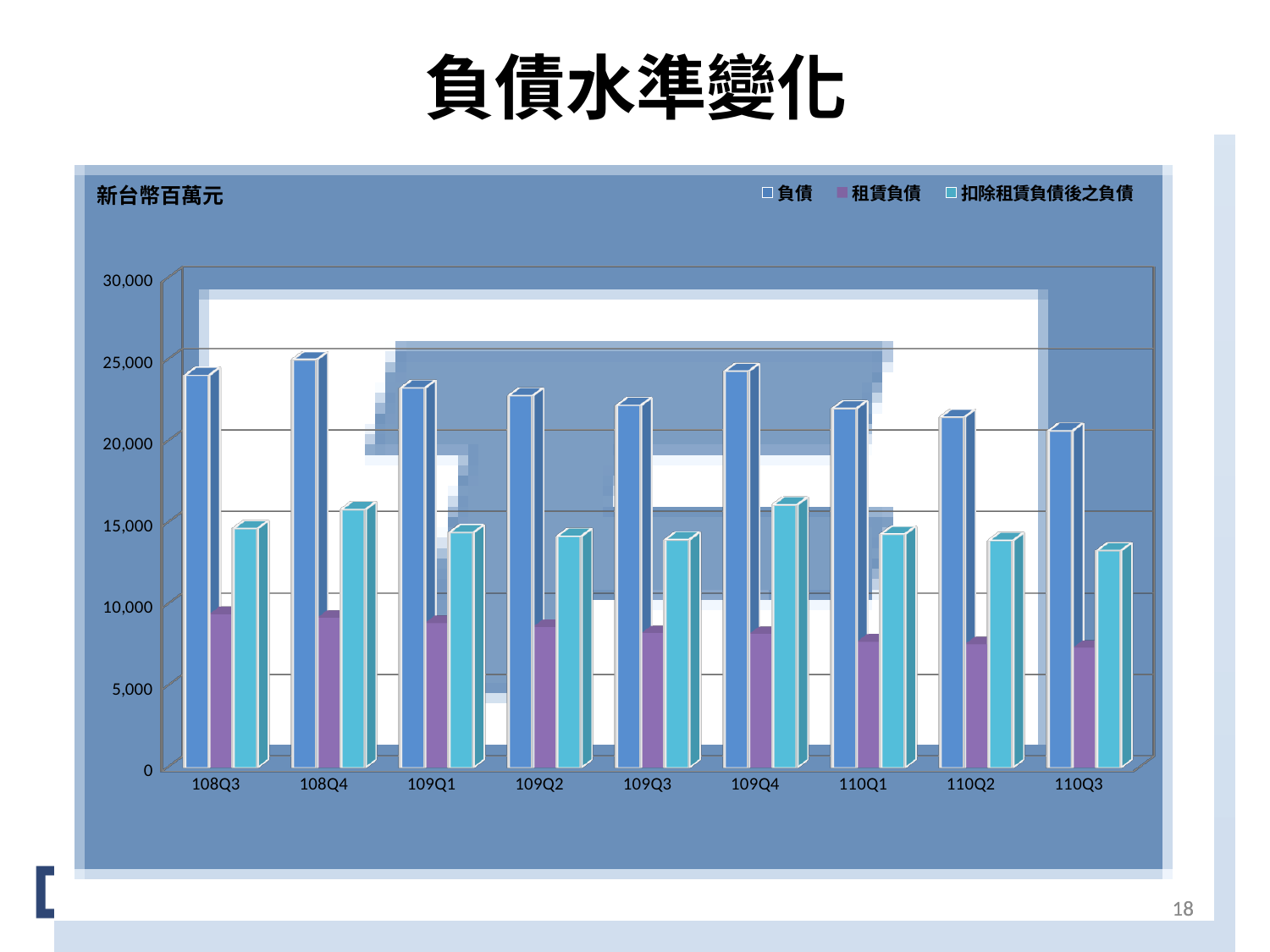
Which is larger, the 負債 value for 108Q3 or for 110Q3? 108Q3 What is the title of the chart? 負債水準變化 Is the value of 租賃負債 for 108Q3 greater or less than 10,000? less Is the value of 扣除租賃負債後之負債 for 108Q4 greater or less than 15,000? greater Is the value of 負債 for 108Q3 greater or less than 25,000? less What unit is stated in the top-left corner of the chart? 新台幣百萬元 How many quarters are shown on the x axis? 9 Which quarter has the lowest value of 負債? 110Q3 What kind of chart is shown on the slide? bar chart How many series does the legend list? 3 Does the 租賃負債 series rise or fall from 108Q3 to 110Q3? fall